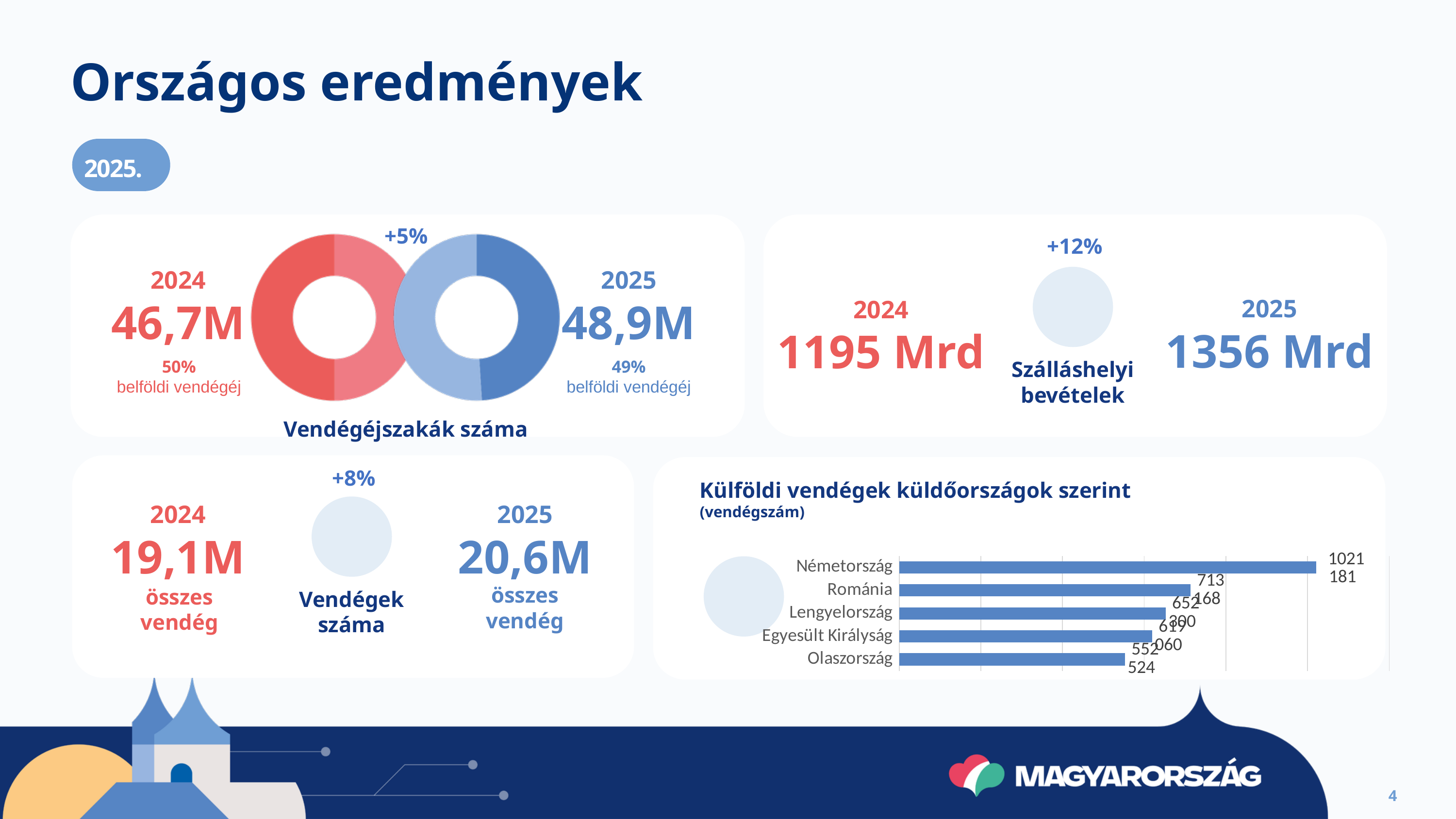
In the 'Külföldi vendégek küldőországok szerint' chart, how many countries are shown? 5 In the 'Külföldi vendégek küldőországok szerint' chart, which country has the lowest number of guests? Olaszország In the 'Vendégéjszakák száma' panel, what percentage change is shown between the 2024 and 2025 donut charts? +5% In the 'Vendégéjszakák száma' panel, what is the total number of guest nights shown for 2025? 48,9M What kind of charts are used in the 'Vendégéjszakák száma' panel? donut (pie) charts In the 'Külföldi vendégek küldőországok szerint' chart, do the bar values rise or fall from top to bottom? fall In the 'Külföldi vendégek küldőországok szerint' chart, which has more guests, Egyesült Királyság or Olaszország? Egyesült Királyság What kind of chart is used in the 'Külföldi vendégek küldőországok szerint' panel? bar chart In the 'Külföldi vendégek küldőországok szerint' chart, which country has the highest number of guests? Németország In the 'Vendégéjszakák száma' panel, what share of guest nights in 2024 were domestic (belföldi vendégéj)? 50% In the 'Vendégéjszakák száma' panel, what share of guest nights in 2025 were domestic (belföldi vendégéj)? 49% In the 'Külföldi vendégek küldőországok szerint' chart, which has more guests, Románia or Lengyelország? Románia